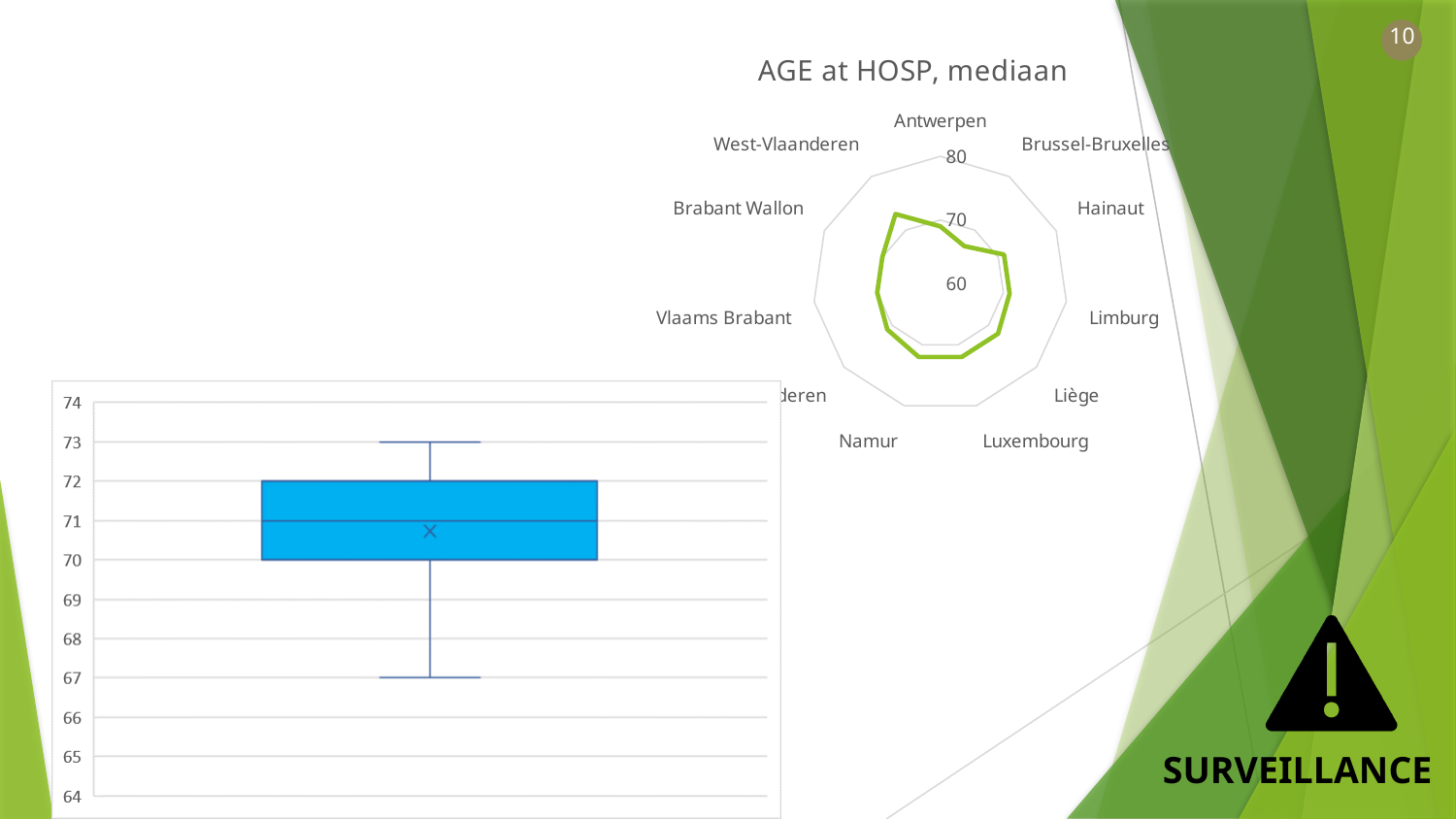
On the radar chart titled "AGE at HOSP, mediaan", is the value for West-Vlaanderen greater or less than 60? greater On the box plot on the left of the slide, at what value is the median line drawn? 71 On the box plot on the left of the slide, what value does the lower whisker reach? 67 On the radar chart titled "AGE at HOSP, mediaan", what is the highest value shown on the radial axis? 80 On the box plot on the left of the slide, what value does the upper whisker reach? 73 How many provinces (categories) are plotted on the radar chart titled "AGE at HOSP, mediaan"? 11 What kind of chart is the chart on the left of the slide? box plot What is the title of the radar chart on the right of the slide? AGE at HOSP, mediaan On the box plot on the left of the slide, what are the lower and upper edges of the box? 70 and 72 What kind of chart is the chart titled "AGE at HOSP, mediaan"? radar chart On the radar chart titled "AGE at HOSP, mediaan", is the value for Limburg greater or less than 80? less On the box plot on the left of the slide, what is the difference between the upper whisker and the lower whisker? 6